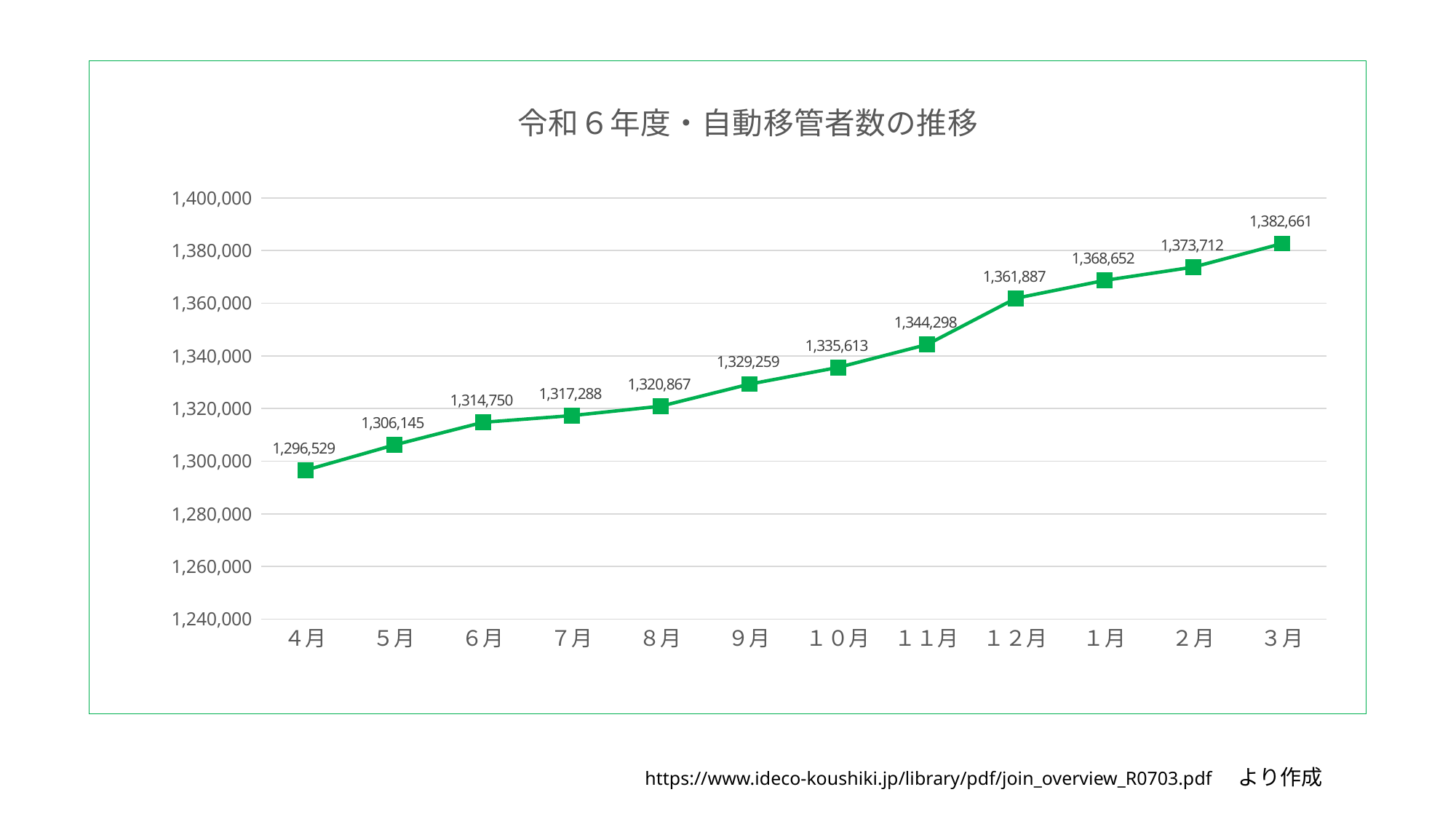
Which month has the highest value? 3月 What kind of chart is shown? line chart What is the value for 3月? 1,382,661 What is the value for 10月? 1,335,613 What is the difference between the values for 12月 and 11月? 17,589 How many months are plotted on the chart? 12 Is the value for 12月 greater or less than 1,360,000? greater What is the value for 4月? 1,296,529 What is the difference between the values for 3月 and 4月? 86,132 Do the values rise or fall from 4月 to 3月? rise Which is larger, the value for 9月 or the value for 1月? 1月 Which month has the lowest value? 4月